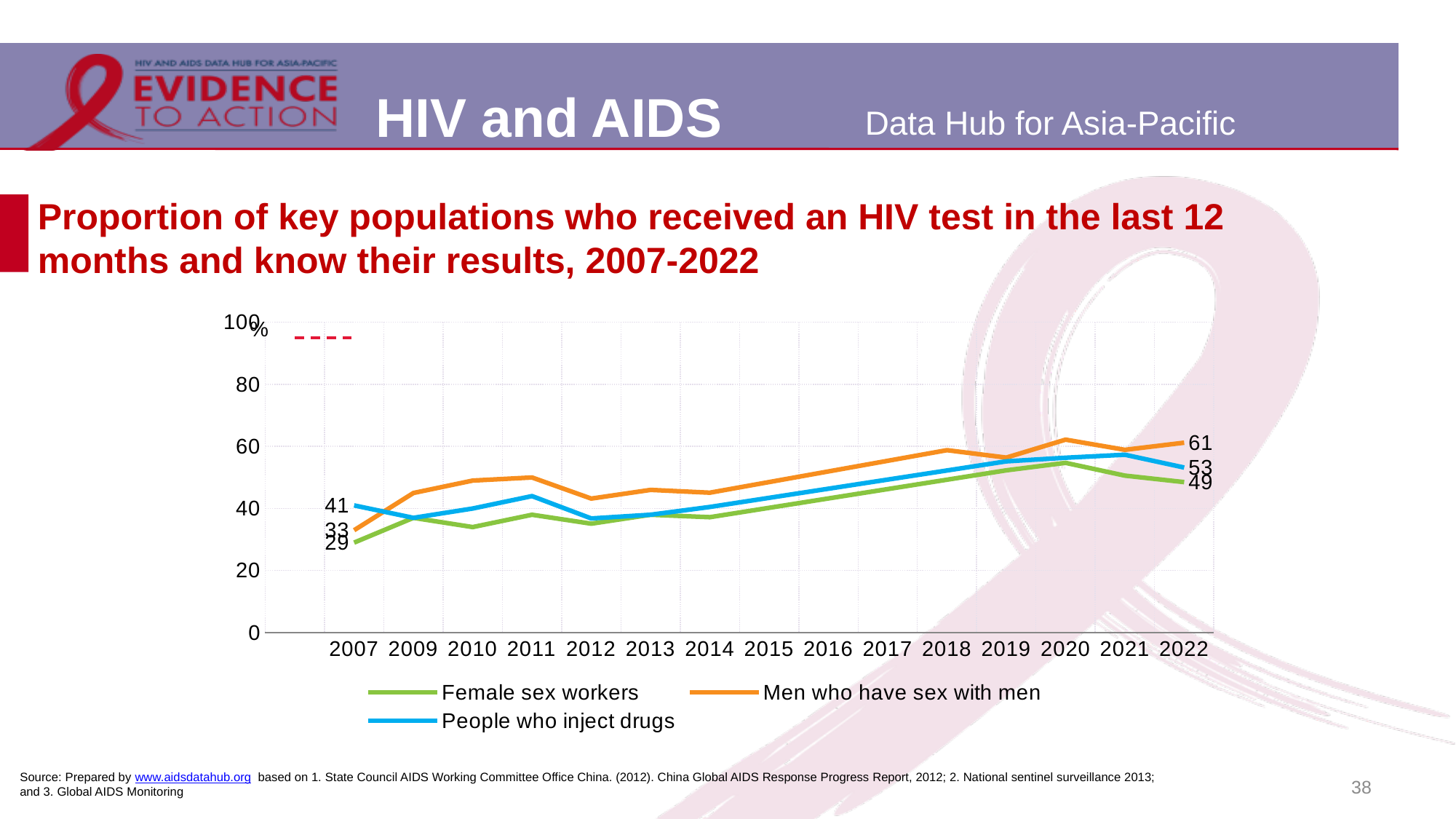
What is the value for Men who have sex with men in 2022? 61 What is the value for People who inject drugs in 2007? 41 What is the value for Female sex workers in 2022? 49 Is the value for Men who have sex with men in 2018 greater or less than 40? greater Which series has the lowest value in 2007? Female sex workers What is the value for Female sex workers in 2007? 29 In 2007, which is larger: the value for People who inject drugs or the value for Men who have sex with men? People who inject drugs Which series has the highest value in 2022? Men who have sex with men How many years are shown on the x axis? 15 What kind of chart is shown on the slide? line chart What is the difference between the 2022 and 2007 values for Men who have sex with men? 28 How many series does the legend list? 3